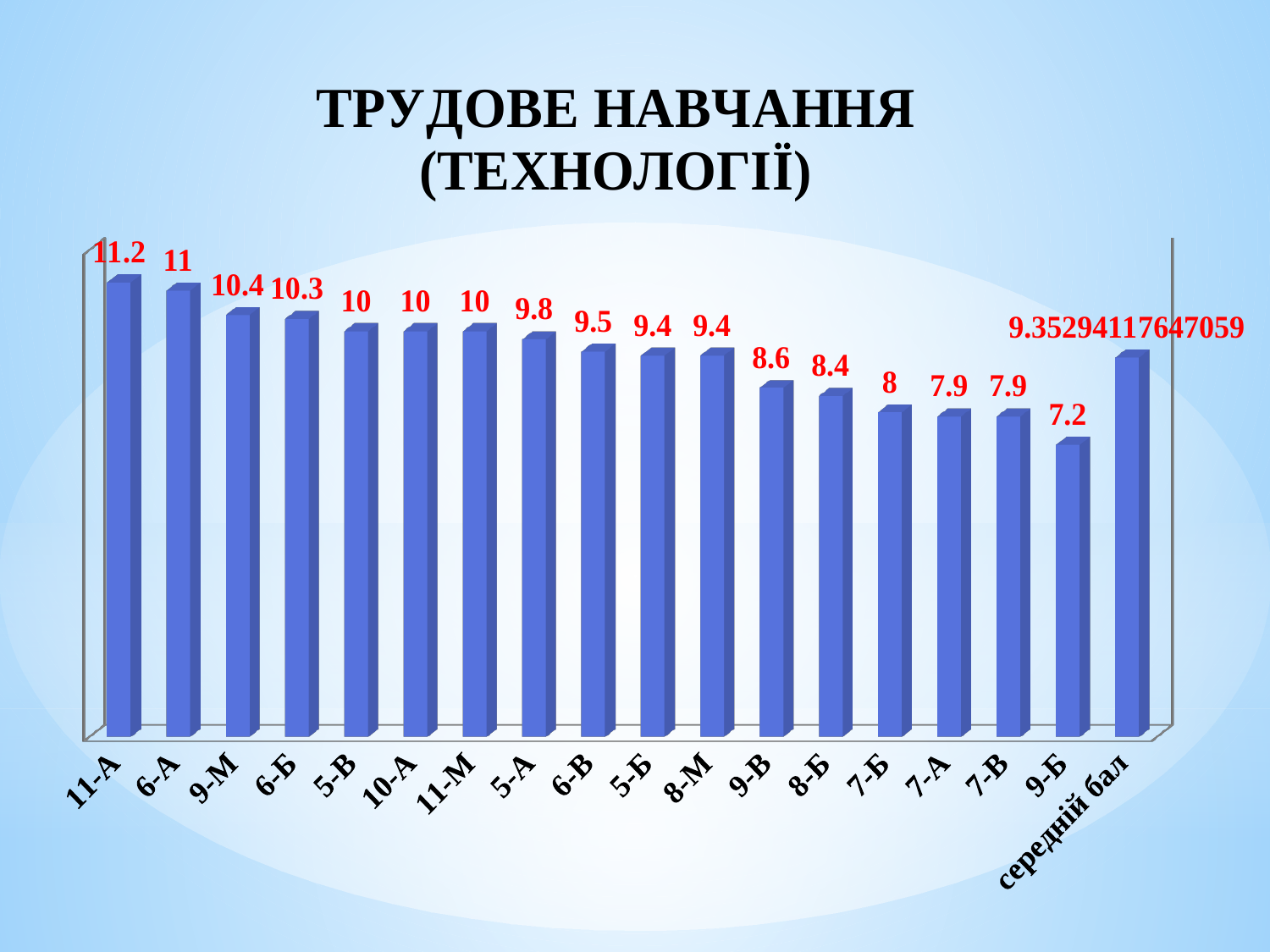
What is the difference between the values for 9-М and 9-В? 1.8 Which category has the highest value? 11-А What is the value for 11-А? 11.2 Which category has the lowest value? 9-Б What is the value for 8-Б? 8.4 What is the title of the slide? ТРУДОВЕ НАВЧАННЯ (ТЕХНОЛОГІЇ) Which is larger, the value for 6-А or the value for 7-Б? 6-А What is the difference between the values for 11-А and 9-Б? 4 How many bars are shown in the chart? 18 What is the value shown for середній бал? 9.35294117647059 What kind of chart is shown on the slide? Bar chart What is the value for 9-Б? 7.2